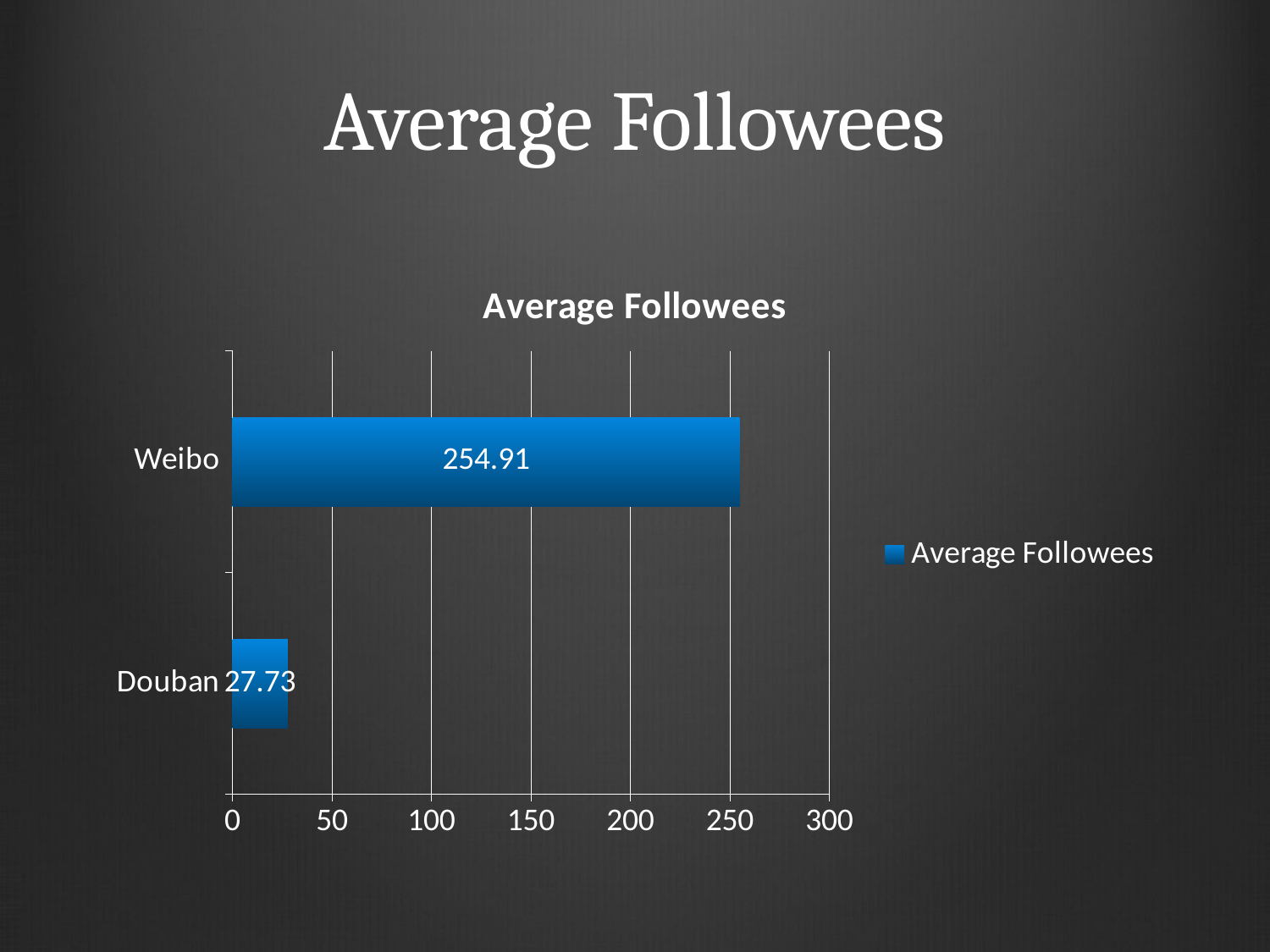
What is the average followees value for Douban? 27.73 What is the average followees value for Weibo? 254.91 What kind of chart is shown on the slide? bar chart Is the value for Douban greater or less than 50? less Which platform has the lowest average followees? Douban What is the title of the chart? Average Followees How many platforms are shown in the chart? 2 What is the difference in average followees between Weibo and Douban? 227.18 Which platform has the highest average followees? Weibo How many series does the legend list? 1 Which has more average followees, Douban or Weibo? Weibo Is the value for Weibo greater or less than 200? greater